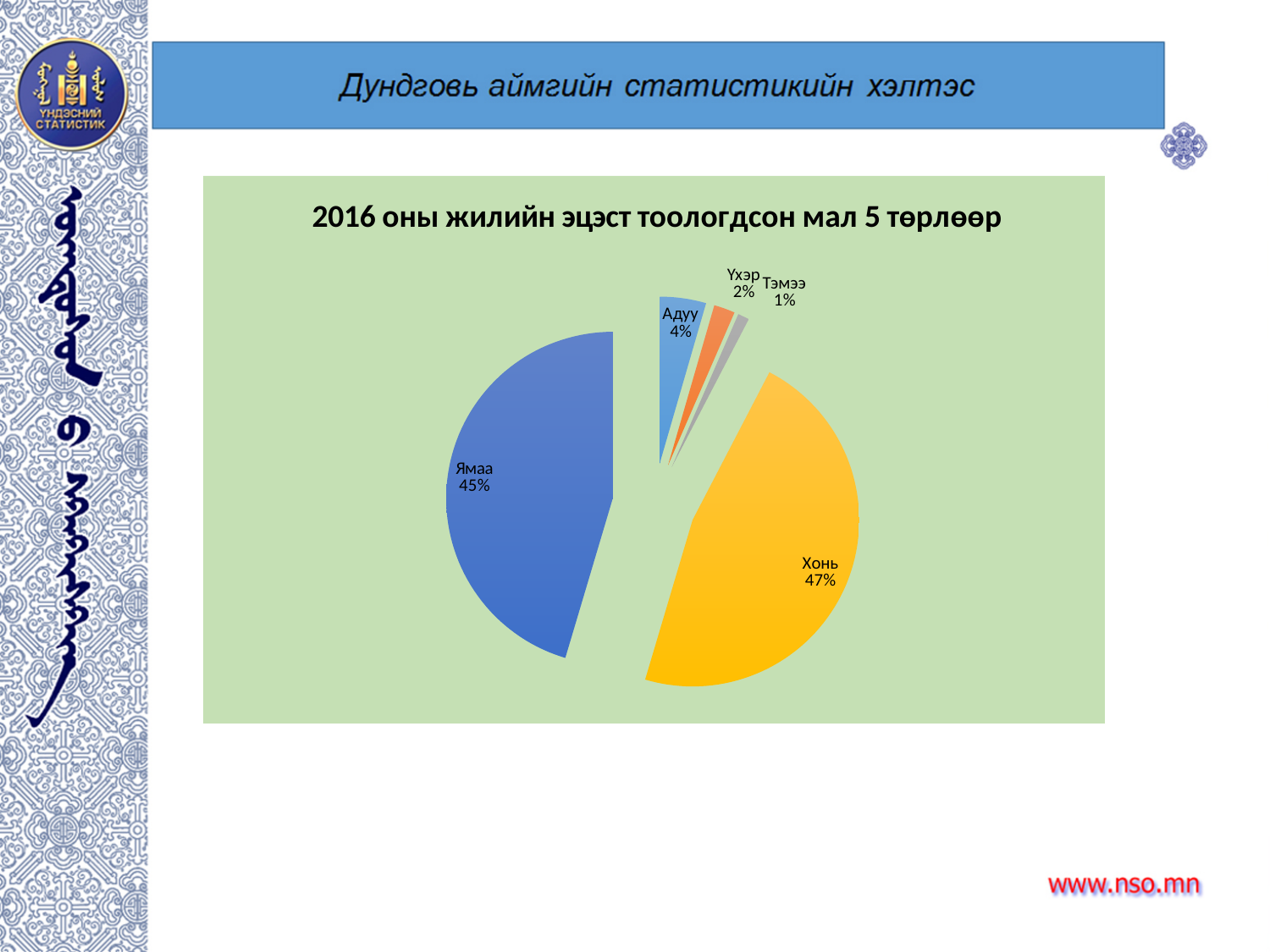
What is the difference in percentage points between Хонь and Ямаа? 2 What share of the pie does Тэмээ have? 1% How many categories are shown in the pie chart? 5 Which category has the smallest slice of the pie? Тэмээ What share of the pie does Ямаа have? 45% What kind of chart is shown on the slide? Pie chart What share of the pie does Үхэр have? 2% What is the title of the chart? 2016 оны жилийн эцэст тоологдсон мал 5 төрлөөр Which is larger, the share for Адуу or the share for Үхэр? Адуу Which category has the largest slice of the pie? Хонь